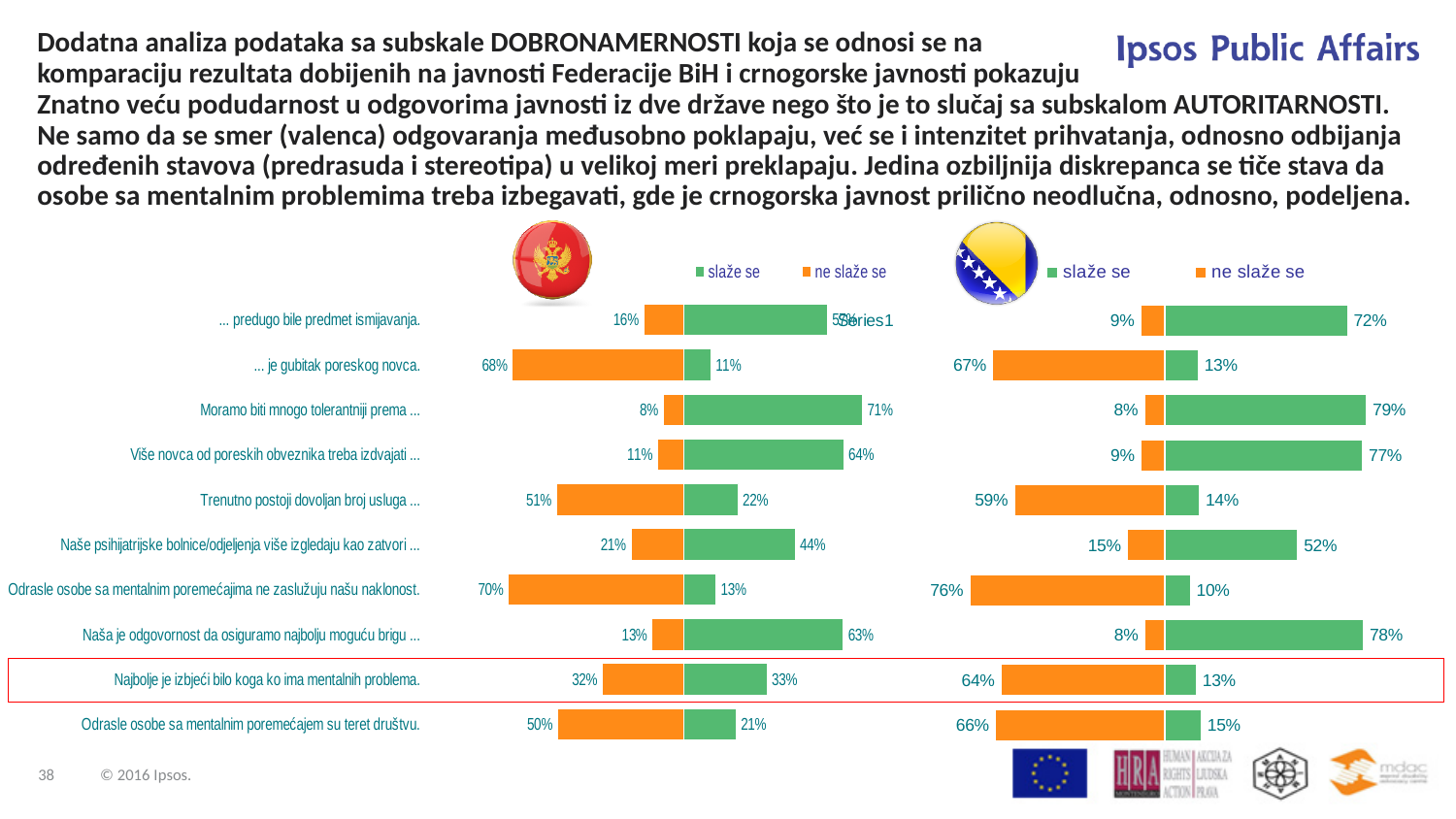
In the left chart (Montenegro flag), what is the 'ne slaže se' value for '... je gubitak poreskog novca.'? 68% In the right chart (Bosnia and Herzegovina flag), what is the 'slaže se' value for 'Moramo biti mnogo tolerantniji prema ...'? 79% In the left chart (Montenegro flag), what is the 'slaže se' value for 'Naša je odgovornost da osiguramo najbolju moguću brigu ...'? 63% In the right chart (Bosnia and Herzegovina flag), what is the difference between the 'ne slaže se' and 'slaže se' values for 'Najbolje je izbjeći bilo koga ko ima mentalnih problema.'? 51 percentage points How many series does the legend of the right chart list? 2 What are the two legend entries shown above the charts? slaže se and ne slaže se In the left chart (Montenegro flag), which statement has the lowest 'ne slaže se' value? Moramo biti mnogo tolerantniji prema ... In the left chart (Montenegro flag), what is the total of the 'ne slaže se' and 'slaže se' values for 'Odrasle osobe sa mentalnim poremećajem su teret društvu.'? 71% In the right chart (Bosnia and Herzegovina flag), which statement has the highest 'ne slaže se' value? Odrasle osobe sa mentalnim poremećajima ne zaslužuju našu naklonost. For 'Trenutno postoji dovoljan broj usluga ...', is the 'ne slaže se' value larger in the left chart or the right chart? right chart How many statements (categories) are shown in the left chart? 10 What type of chart is used on this slide? bar chart